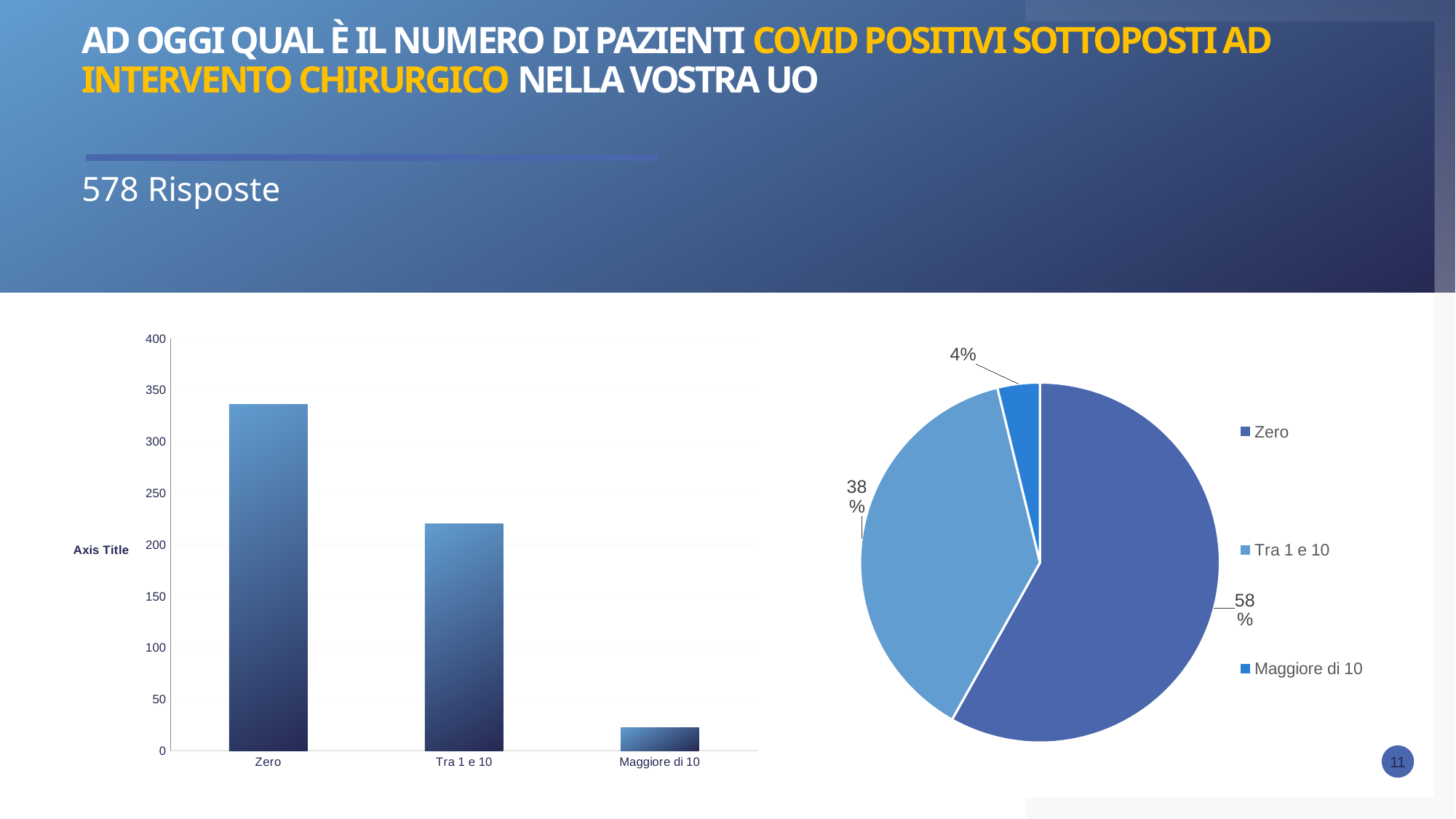
In the pie chart on the right, what share does the Maggiore di 10 slice have? 4% In the bar chart on the left, which category has the highest bar? Zero In the bar chart on the left, is the value for Zero greater or less than 300? greater In the pie chart on the right, what share does the Zero slice have? 58% In the bar chart on the left, is the value for Maggiore di 10 greater or less than 50? less What kind of chart is the chart on the right of the slide? pie chart In the pie chart on the right, what share does the Tra 1 e 10 slice have? 38% In the bar chart on the left, which category has the lowest bar? Maggiore di 10 In the bar chart on the left, how many categories are shown on the x axis? 3 In the bar chart on the left, is the value for Tra 1 e 10 greater or less than 250? less In the pie chart on the right, how many entries does the legend list? 3 What kind of chart is the chart on the left of the slide? bar chart